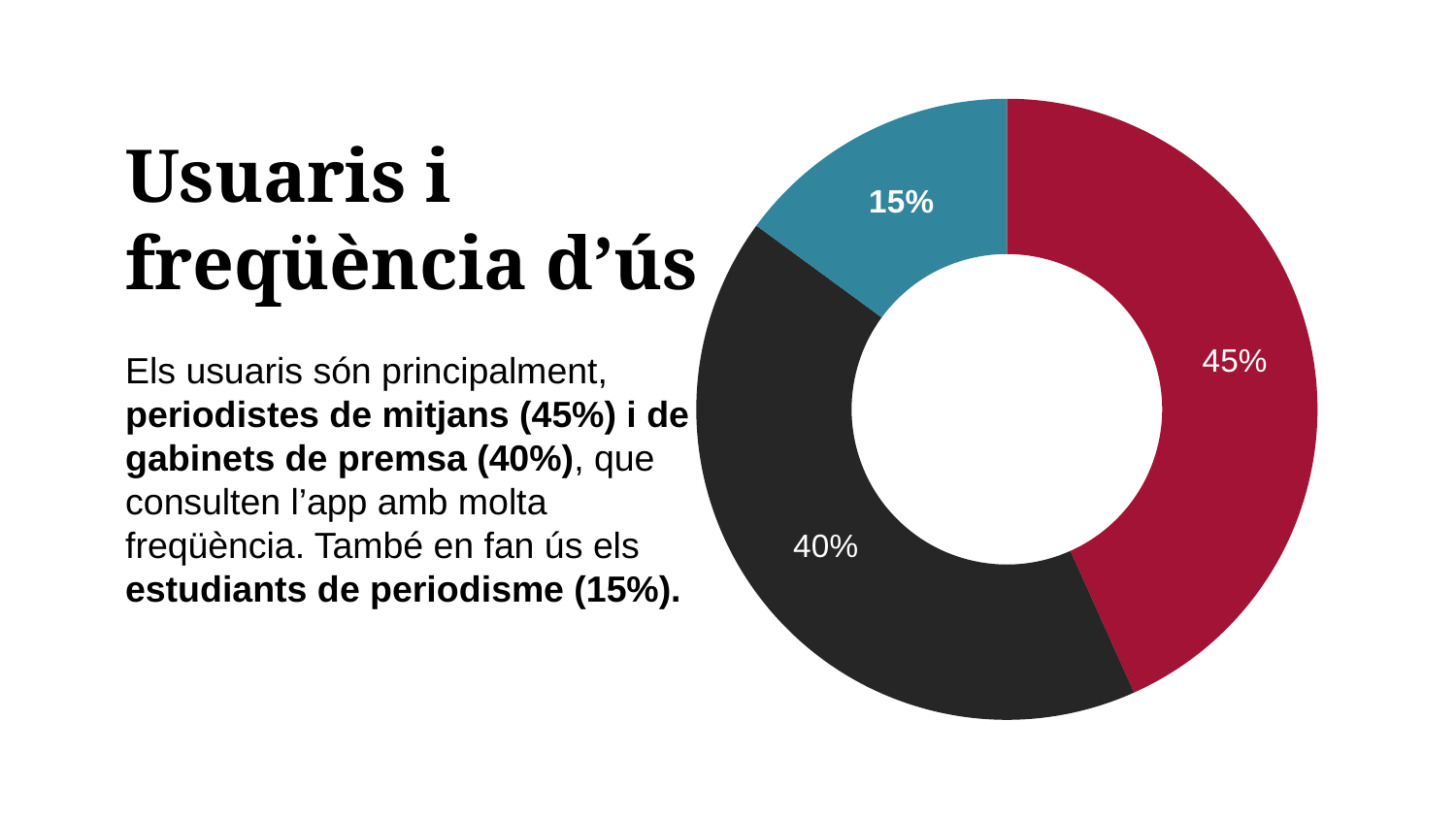
What is the value shown on the red slice of the donut chart? 45% What is the title of the slide containing the donut chart? Usuaris i freqüència d'ús What kind of chart is shown on the slide? Pie chart (donut) Which slice is larger in the donut chart, the black one or the teal one? The black one (40%) What is the smallest value shown in the donut chart? 15% What is the value shown on the black slice of the donut chart? 40% How many slices does the donut chart have? 3 What is the difference between the largest and smallest slices of the donut chart? 30% According to the slide text, which user group corresponds to the 45% slice? Periodistes de mitjans What is the value shown on the teal slice of the donut chart? 15% What is the difference between the red slice and the black slice in the donut chart? 5% What is the largest value shown in the donut chart? 45%